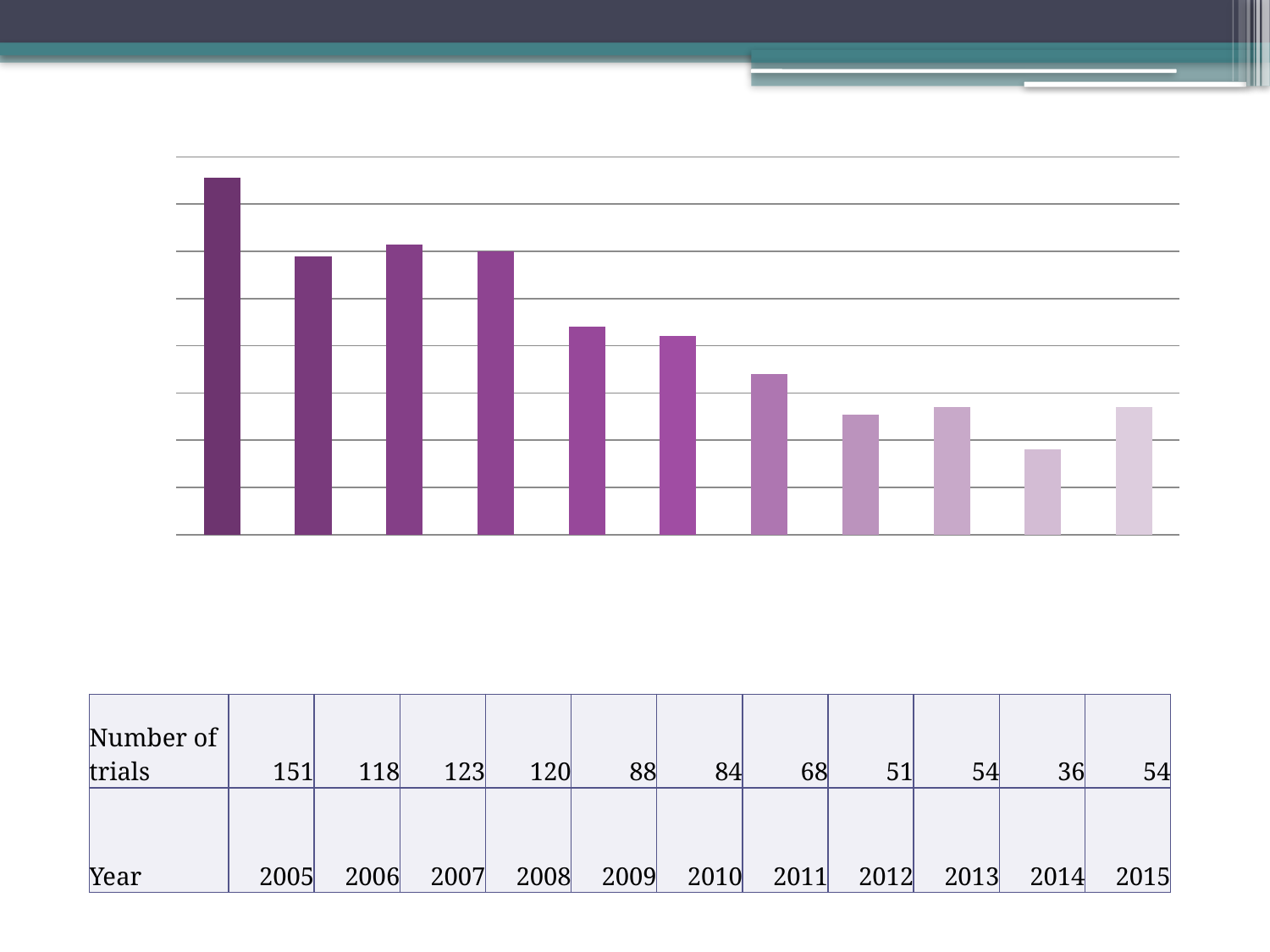
What is the difference in the number of trials between 2011 and 2012? 17 Which year has the highest number of trials? 2005 Overall, do the number of trials rise or fall from 2005 to 2015? fall How many bars does the chart have? 11 Which year has the lowest number of trials? 2014 What is the difference in the number of trials between 2005 and 2006? 33 What kind of chart is shown on the slide? bar chart According to the table, what is the number of trials for 2009? 88 According to the table, what is the number of trials for 2014? 36 According to the table, what is the number of trials for 2005? 151 Which year has more trials, 2007 or 2008? 2007 Which two years in the table have the same number of trials? 2013 and 2015